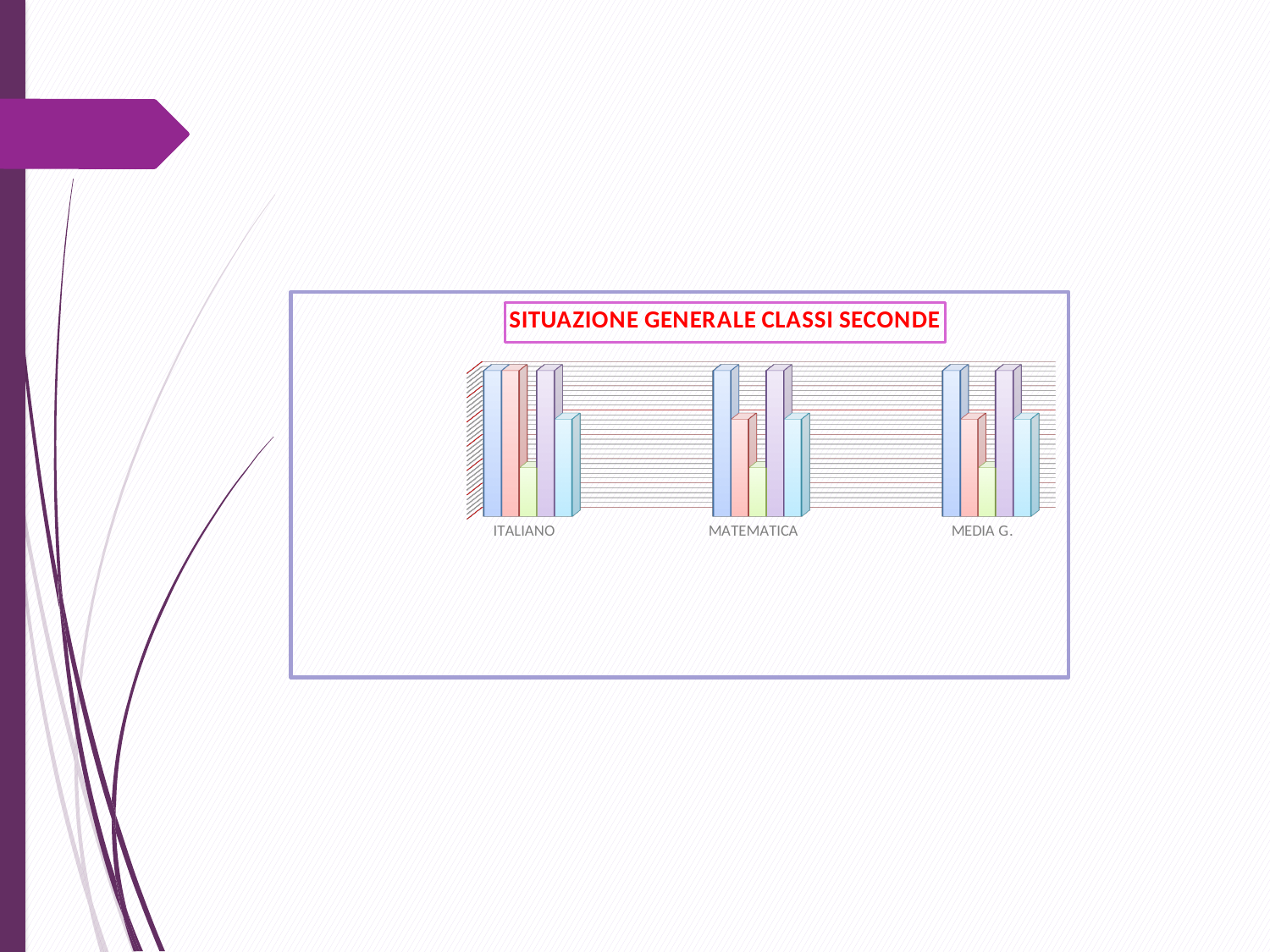
What is the title of the chart? SITUAZIONE GENERALE CLASSI SECONDE Which category is labelled in the middle of the x axis? MATEMATICA In the MATEMATICA group, which coloured bar is the shortest? green In the MATEMATICA group, which is taller: the blue bar or the red bar? blue In the MEDIA G. group, which is taller: the purple bar or the red bar? purple How many bars are plotted for each category in the chart? 5 In the ITALIANO group, which is taller: the blue bar or the light blue bar? blue In the ITALIANO group, which coloured bar is the shortest? green What kind of chart is shown on the slide? bar chart How many categories are shown on the x axis of the chart? 3 In the MEDIA G. group, which coloured bar is the shortest? green